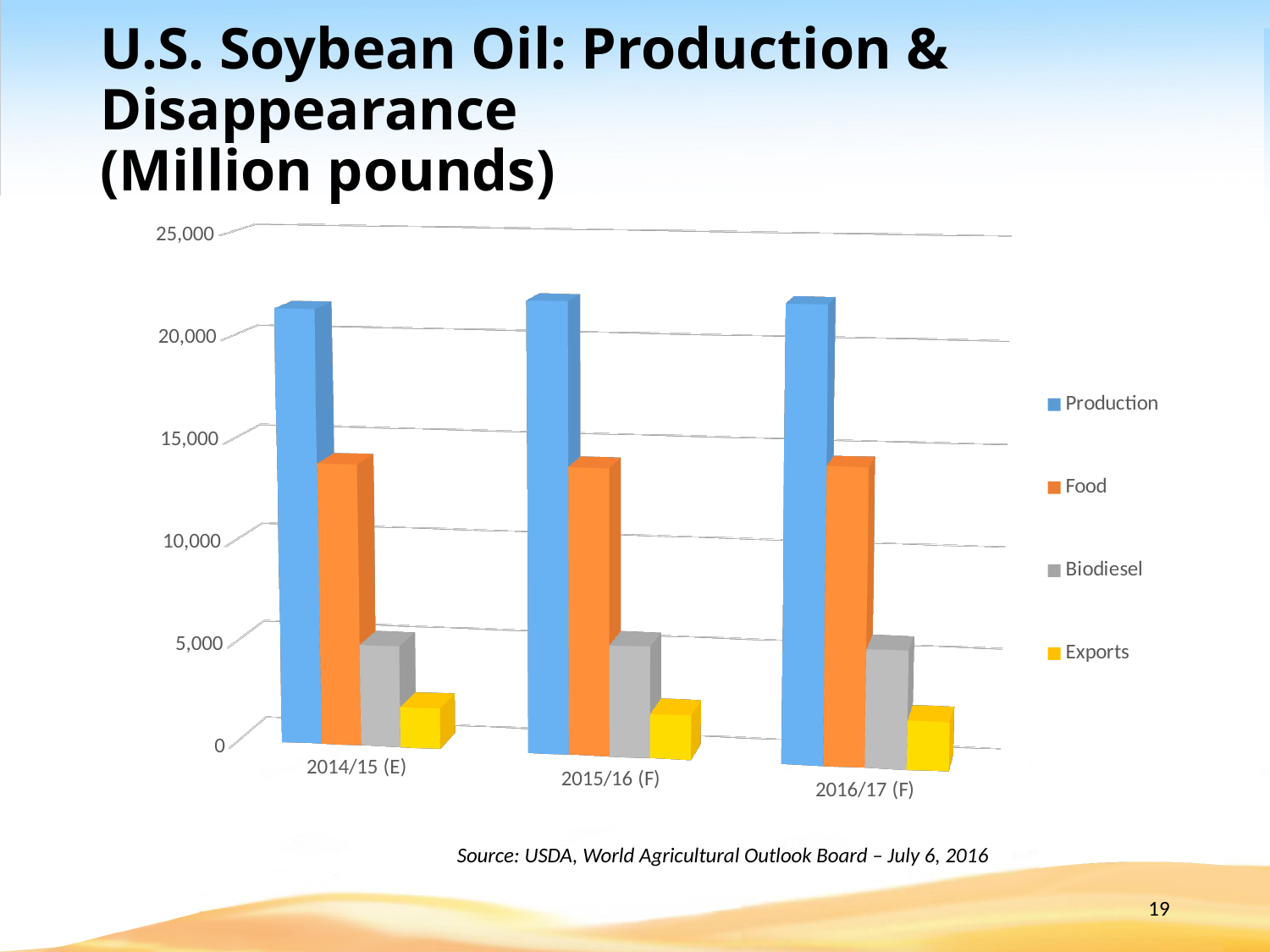
What unit is given in the chart title? Million pounds In 2016/17 (F), which is larger: Food or Biodiesel? Food Which series has the highest value in 2014/15 (E)? Production Is the value for Production in 2015/16 (F) greater or less than 20,000? greater Is the value for Exports in 2015/16 (F) greater or less than 5,000? less Which series has the lowest value in 2016/17 (F)? Exports Is the value for Food in 2014/15 (E) greater or less than 15,000? less What kind of chart is shown on the slide? bar chart How many marketing-year categories are shown on the x axis? 3 How many series does the legend list? 4 Which series is shown in yellow in the legend? Exports